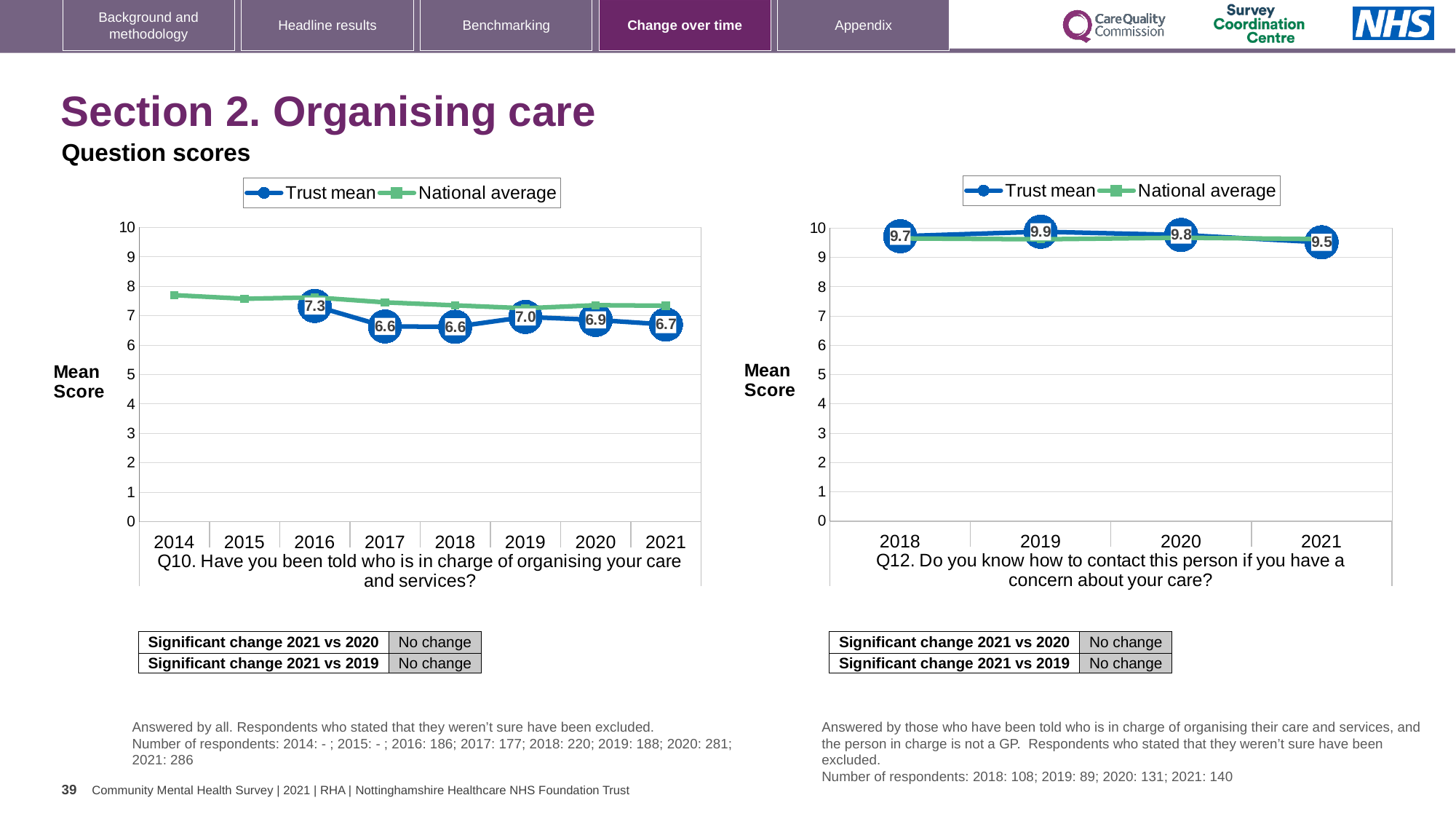
In the Q10 chart on the left, what is the Trust mean for 2016? 7.3 In the Q12 chart on the right, what is the difference between the Trust mean for 2019 and the Trust mean for 2021? 0.4 How many years are shown on the x axis of the Q12 chart on the right? 4 In the Q12 chart on the right, what is the Trust mean for 2019? 9.9 In the Q10 chart on the left, what is the difference between the Trust mean for 2016 and the Trust mean for 2017? 0.7 How many series does the legend of the Q10 chart on the left list? 2 In the Q10 chart on the left, which year has the highest Trust mean? 2016 In the Q12 chart on the right, which year has the lowest Trust mean? 2021 In the Q10 chart on the left, is the Trust mean for 2019 or for 2021 larger? 2019 In the Q10 chart on the left, is the National average for 2014 greater or less than 7? greater In the Q10 chart on the left, what is the Trust mean for 2021? 6.7 What type of chart is the Q12 chart on the right? Line chart